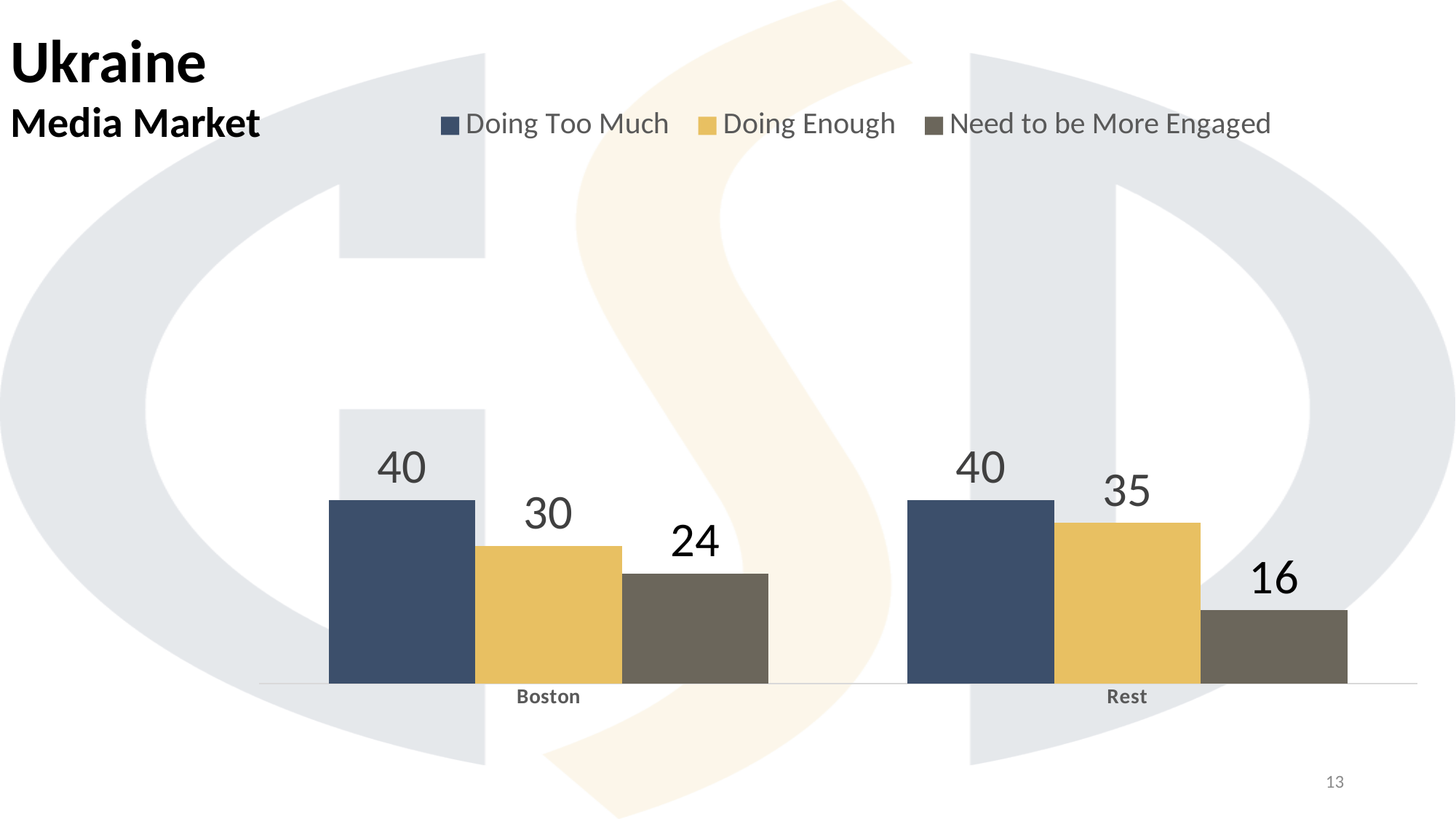
How many categories are shown on the x axis? 2 Which series has the highest value in Boston? Doing Too Much What is the value for "Need to be More Engaged" in Boston? 24 What is the value for "Need to be More Engaged" in Rest? 16 What is the value for "Doing Too Much" in Boston? 40 Which series has the lowest value in Rest? Need to be More Engaged Which is larger: "Doing Enough" in Boston or "Need to be More Engaged" in Boston? Doing Enough in Boston What kind of chart is shown on the slide? Bar chart What is the difference between "Doing Enough" in Rest and "Doing Enough" in Boston? 5 What is the difference between "Need to be More Engaged" in Boston and in Rest? 8 What is the value for "Doing Enough" in Rest? 35 How many series does the legend list? 3